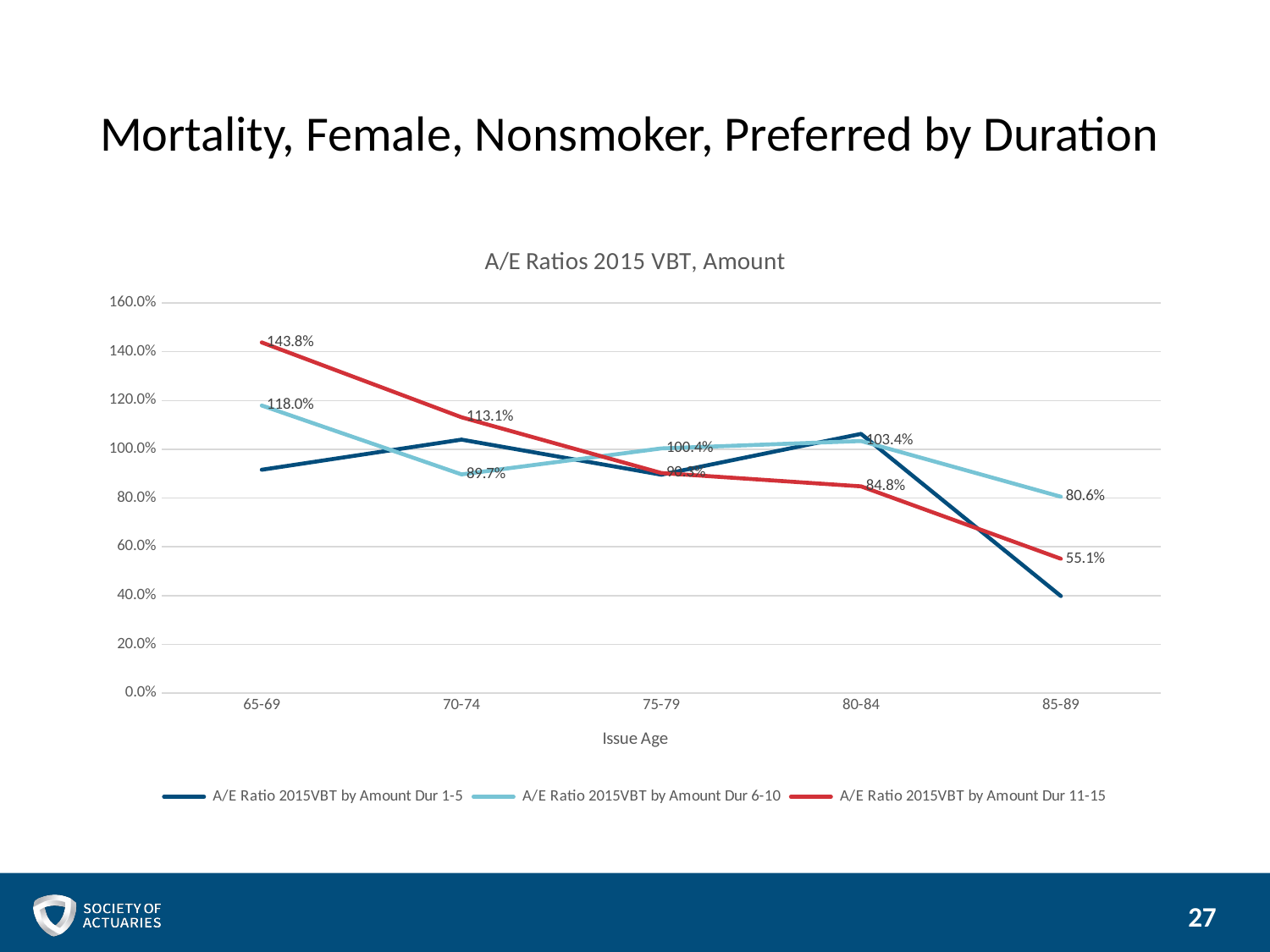
At issue age 85-89, which series has the larger A/E ratio: Dur 6-10 or Dur 11-15? Dur 6-10 What is the A/E ratio for Dur 6-10 at issue age 85-89? 80.6% How many series does the legend list? 3 Is the A/E ratio for Dur 1-5 at issue age 85-89 greater or less than 60.0%? less By how many percentage points does the Dur 11-15 ratio at issue age 65-69 exceed its ratio at issue age 85-89? 88.7 percentage points What is the A/E ratio for Dur 6-10 at issue age 65-69? 118.0% What is the A/E ratio for Dur 11-15 at issue age 80-84? 84.8% What kind of chart is shown on the slide? Line chart What is the A/E ratio for Dur 11-15 at issue age 65-69? 143.8% What is the A/E ratio for Dur 11-15 at issue age 85-89? 55.1% What is the A/E ratio for Dur 11-15 at issue age 70-74? 113.1% How many issue age groups are shown on the x axis? 5